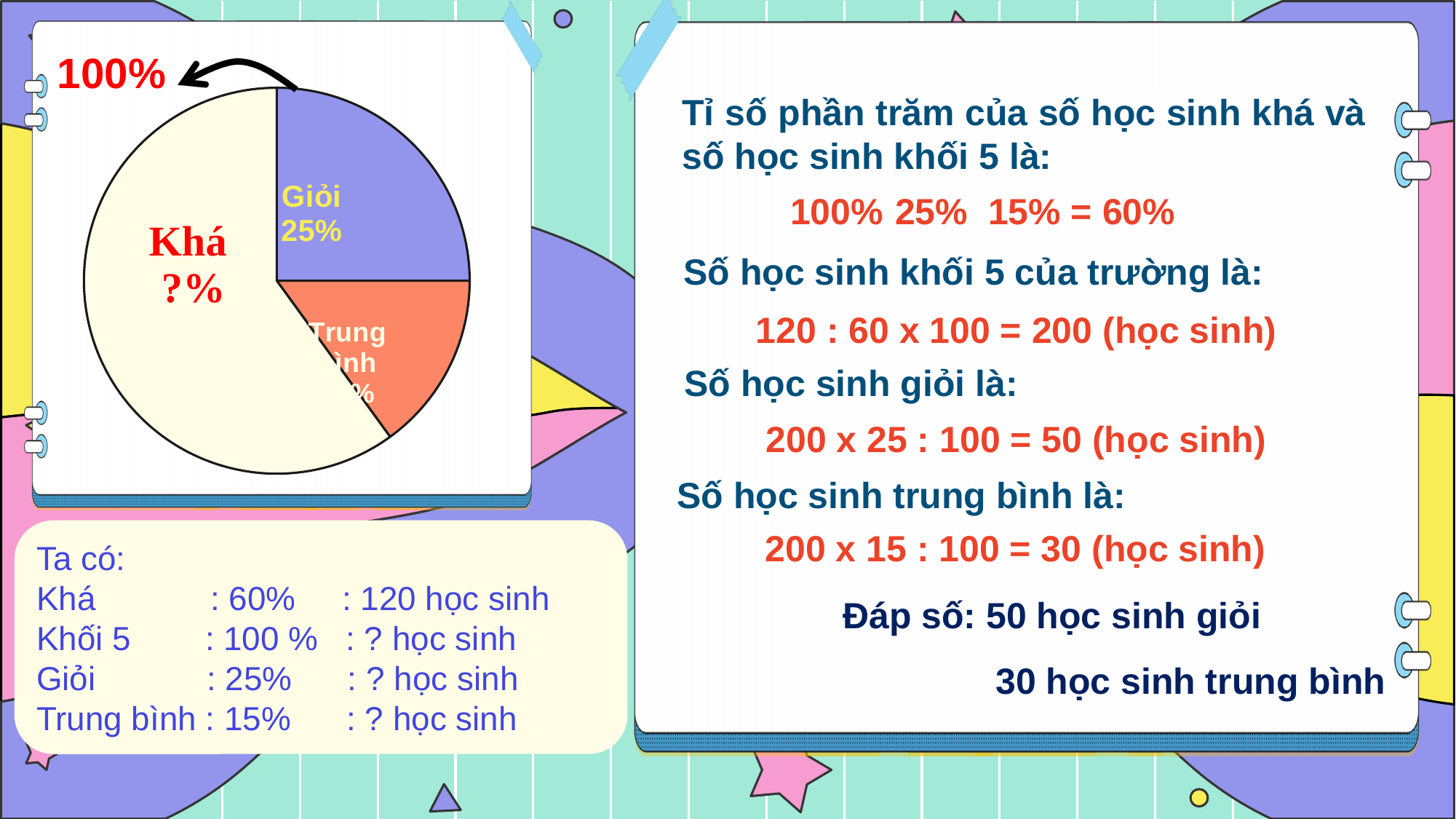
Which slice is larger in the pie chart, Giỏi or Trung bình? Giỏi Which slice of the pie chart is the smallest? Trung bình How many slices does the pie chart have? 3 What colour is the Khá slice in the pie chart? pale yellow What colour is the Giỏi slice in the pie chart? purple Which slice is larger in the pie chart, Khá or Giỏi? Khá What percentage label is written on the Khá slice of the pie chart? ?% What kind of chart is shown on the slide? pie chart What percentage is shown for the Giỏi slice of the pie chart? 25% Which slice of the pie chart is the largest? Khá What share of the pie does the Giỏi slice represent? 25%